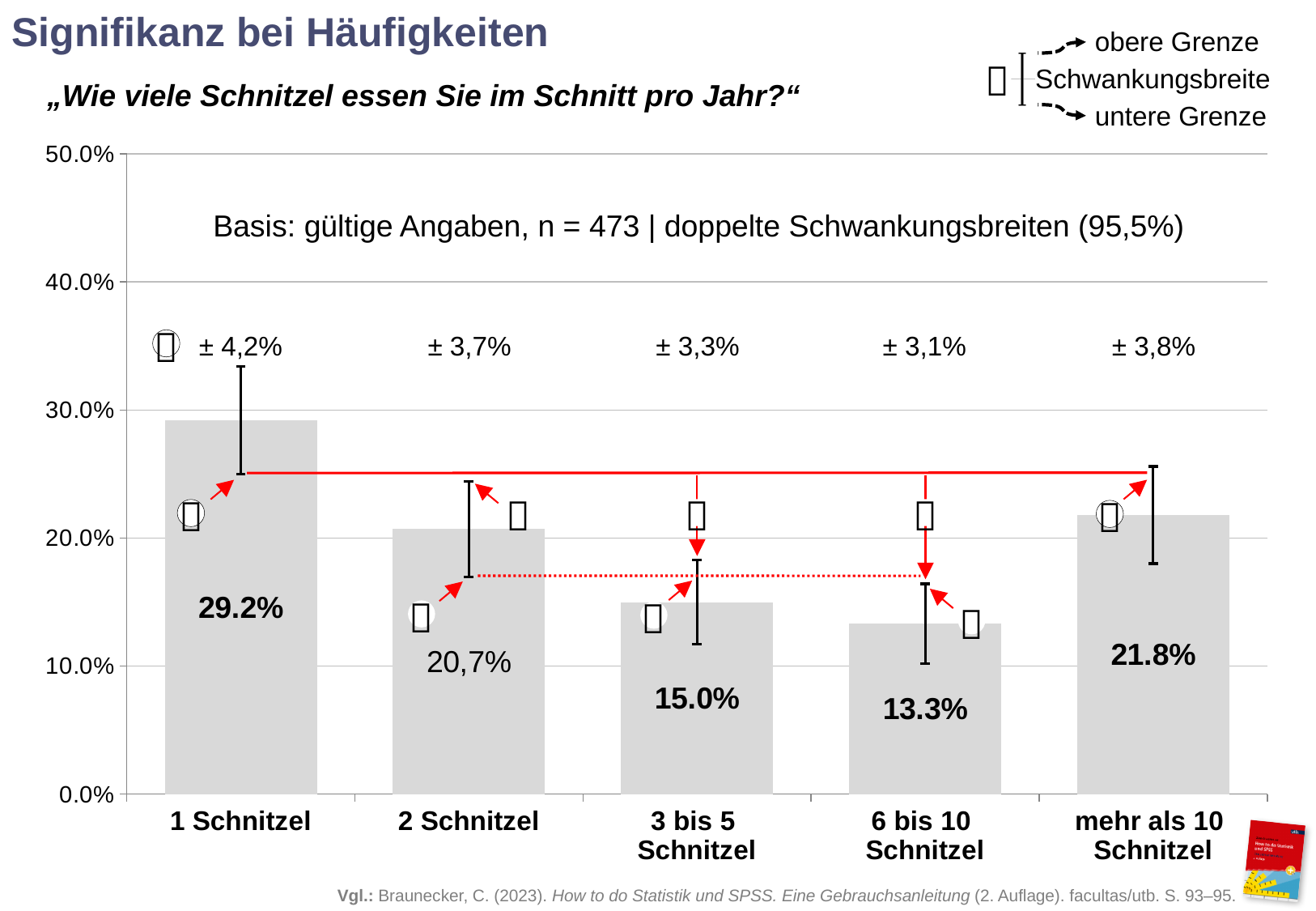
What sample size (n) is stated in the text inside the chart? n = 473 What kind of chart is shown on the slide? bar chart What is the value shown for the category "mehr als 10 Schnitzel"? 21.8% How many categories are shown on the x axis of the chart? 5 What is the value shown for the category "1 Schnitzel"? 29.2% Which is larger, the value for "3 bis 5 Schnitzel" or the value for "mehr als 10 Schnitzel"? mehr als 10 Schnitzel What is the value shown for the category "2 Schnitzel"? 20,7% Which category has the highest value? 1 Schnitzel What is the value shown for the category "6 bis 10 Schnitzel"? 13.3% Which category has the lowest value? 6 bis 10 Schnitzel What margin (Schwankungsbreite) is printed above the bar for "6 bis 10 Schnitzel"? ± 3,1% What is the difference between the values for "1 Schnitzel" and "mehr als 10 Schnitzel"? 7.4 percentage points